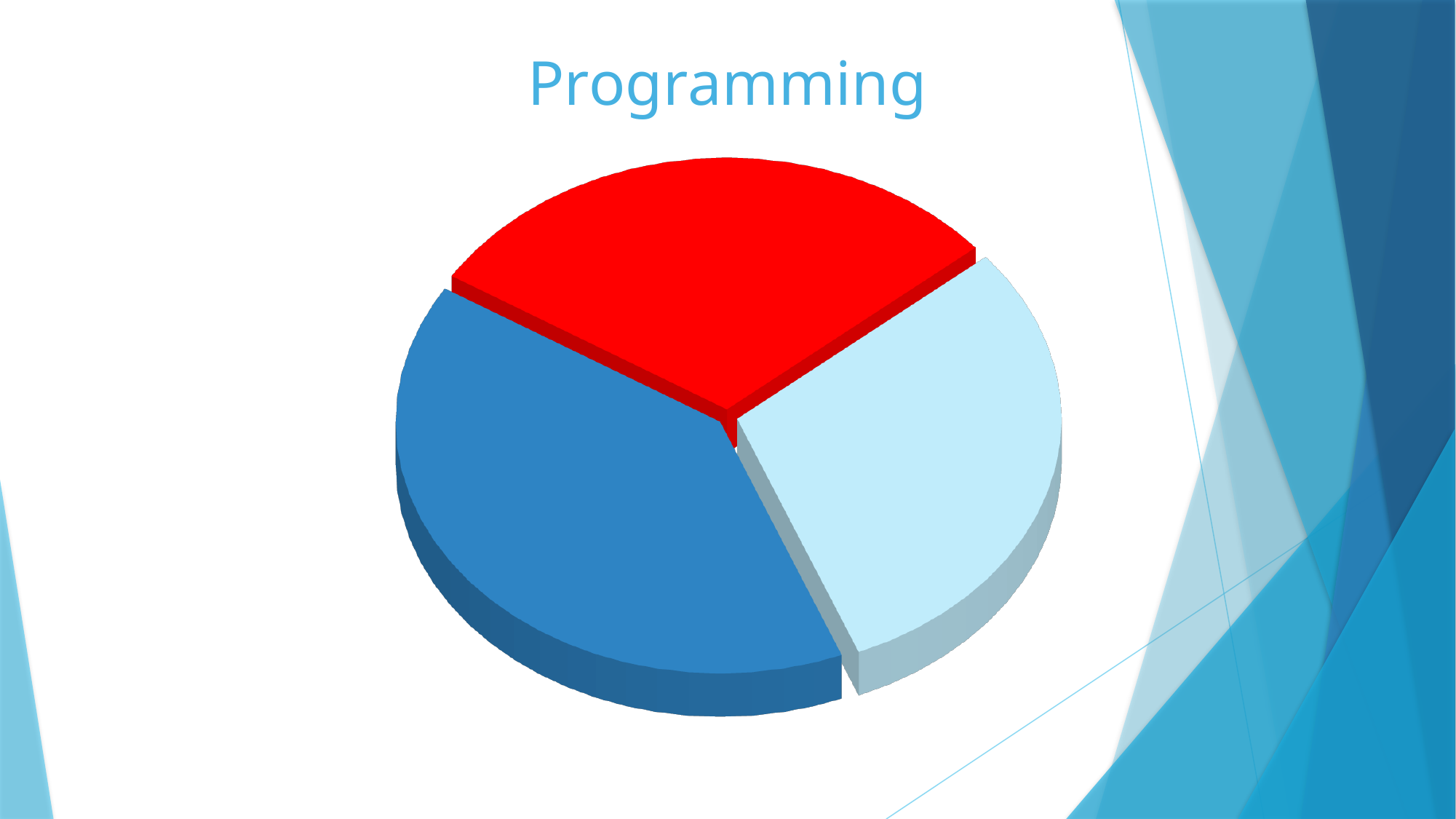
What is the title of the chart? Programming How many slices does the pie chart have? 3 Which is larger, the dark blue slice or the red slice? dark blue Which is larger, the dark blue slice or the light blue slice? dark blue Which colour slice is the largest in the pie chart? dark blue What kind of chart is shown on the slide? pie chart What colours are the three slices of the pie chart? red, dark blue, light blue